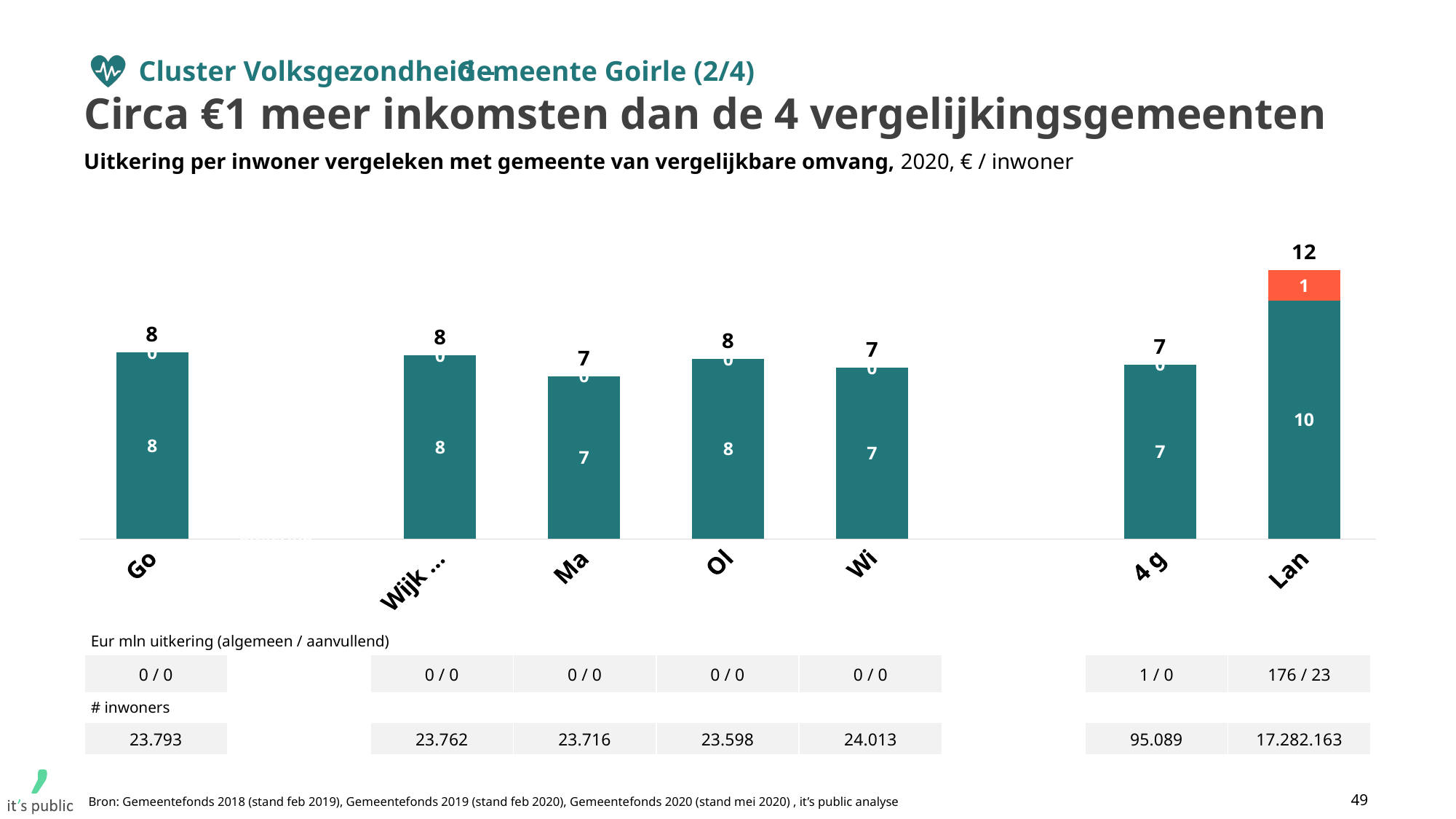
What is the difference between the total for Lan and the total for 4 g? 5 Which category has the highest total value? Lan Which is larger, the total for Go or the total for Wi? Go What is the value of the orange (top) segment of the Lan bar? 1 What kind of chart is shown on the slide? Stacked bar chart What is the total value shown above the bar for Ma? 7 What is the total value shown above the bar for Lan? 12 How many categories are shown on the x axis of the chart? 7 What unit is stated in the chart subtitle for the values? € / inwoner What is the total value shown above the bar for Go? 8 What is the total of the stacked bar for Ol? 8 What is the value of the teal (bottom) segment of the Lan bar? 10